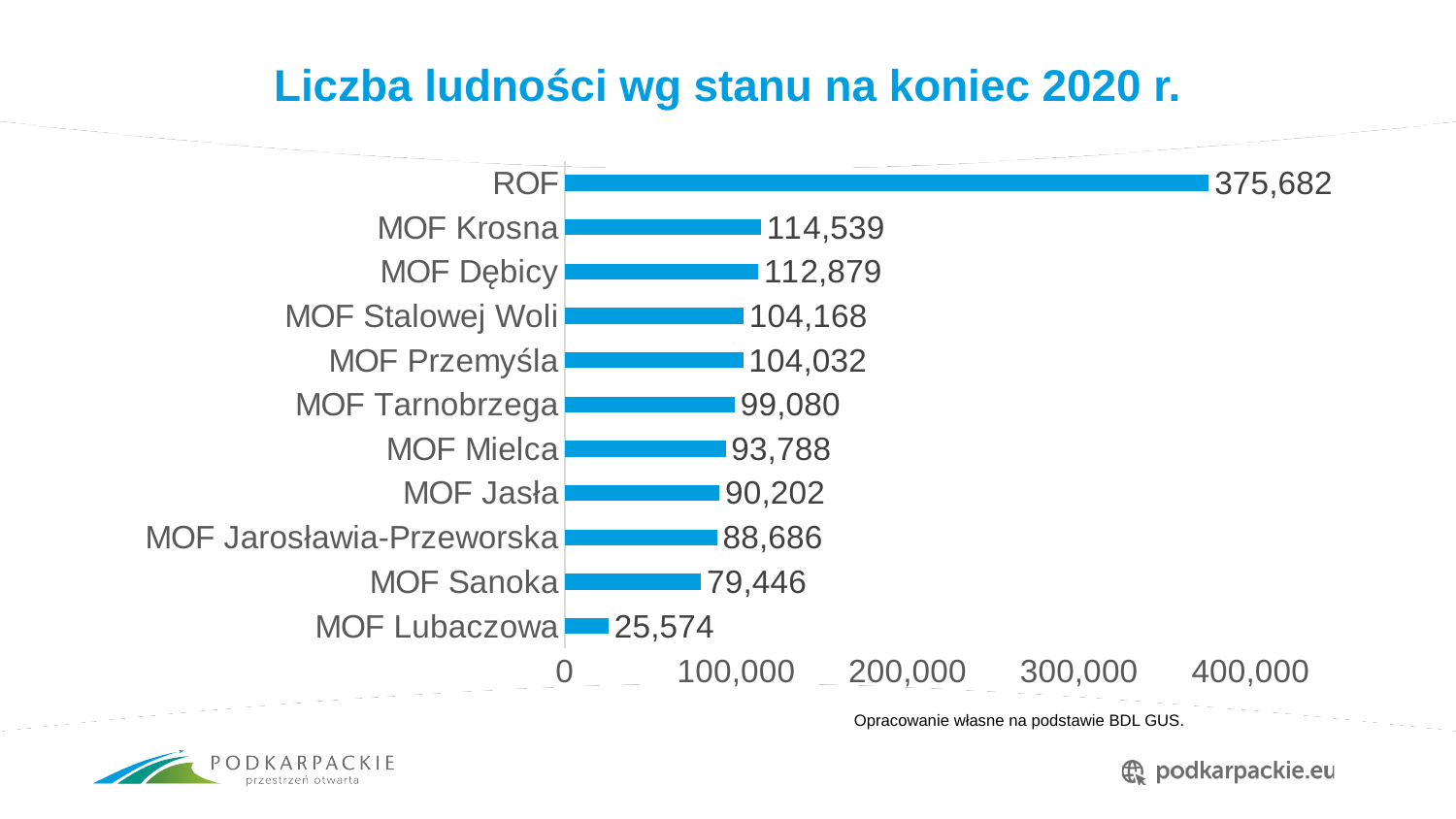
How many categories are shown in the chart? 11 Which category has the lowest population value? MOF Lubaczowa What is the population value shown for MOF Lubaczowa? 25,574 Is the value for MOF Dębicy greater or less than 100,000? greater What is the title of the chart? Liczba ludności wg stanu na koniec 2020 r. What is the difference between the values for ROF and MOF Krosna? 261,143 What is the population value shown for MOF Tarnobrzega? 99,080 What is the difference between the values for MOF Sanoka and MOF Lubaczowa? 53,872 Which has a larger value, MOF Mielca or MOF Jasła? MOF Mielca What is the population value shown for MOF Krosna? 114,539 Which category has the highest population value? ROF What kind of chart is shown on the slide? bar chart